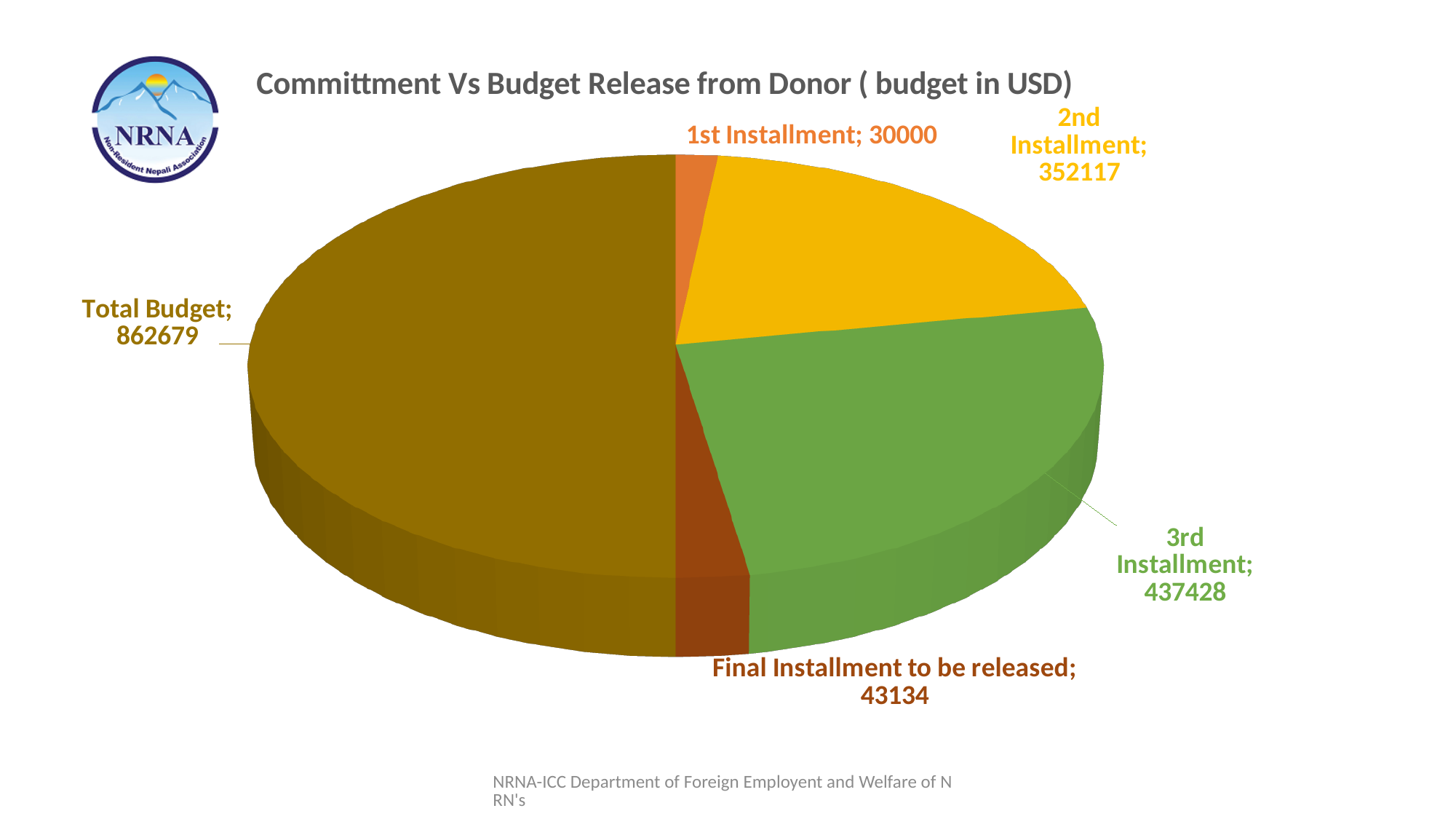
What is the title of the chart? Committment Vs Budget Release from Donor ( budget in USD) What is the value for Total Budget? 862679 What is the difference between the 3rd Installment and the 2nd Installment? 85311 Which is larger, the Final Installment to be released or the 1st Installment? Final Installment to be released What kind of chart is shown on the slide? Pie chart What is the value for the 2nd Installment? 352117 Which slice has the smallest value? 1st Installment What is the value for the Final Installment to be released? 43134 What is the value for the 1st Installment? 30000 Which slice has the largest value? Total Budget How many slices does the pie chart have? 5 What is the value for the 3rd Installment? 437428